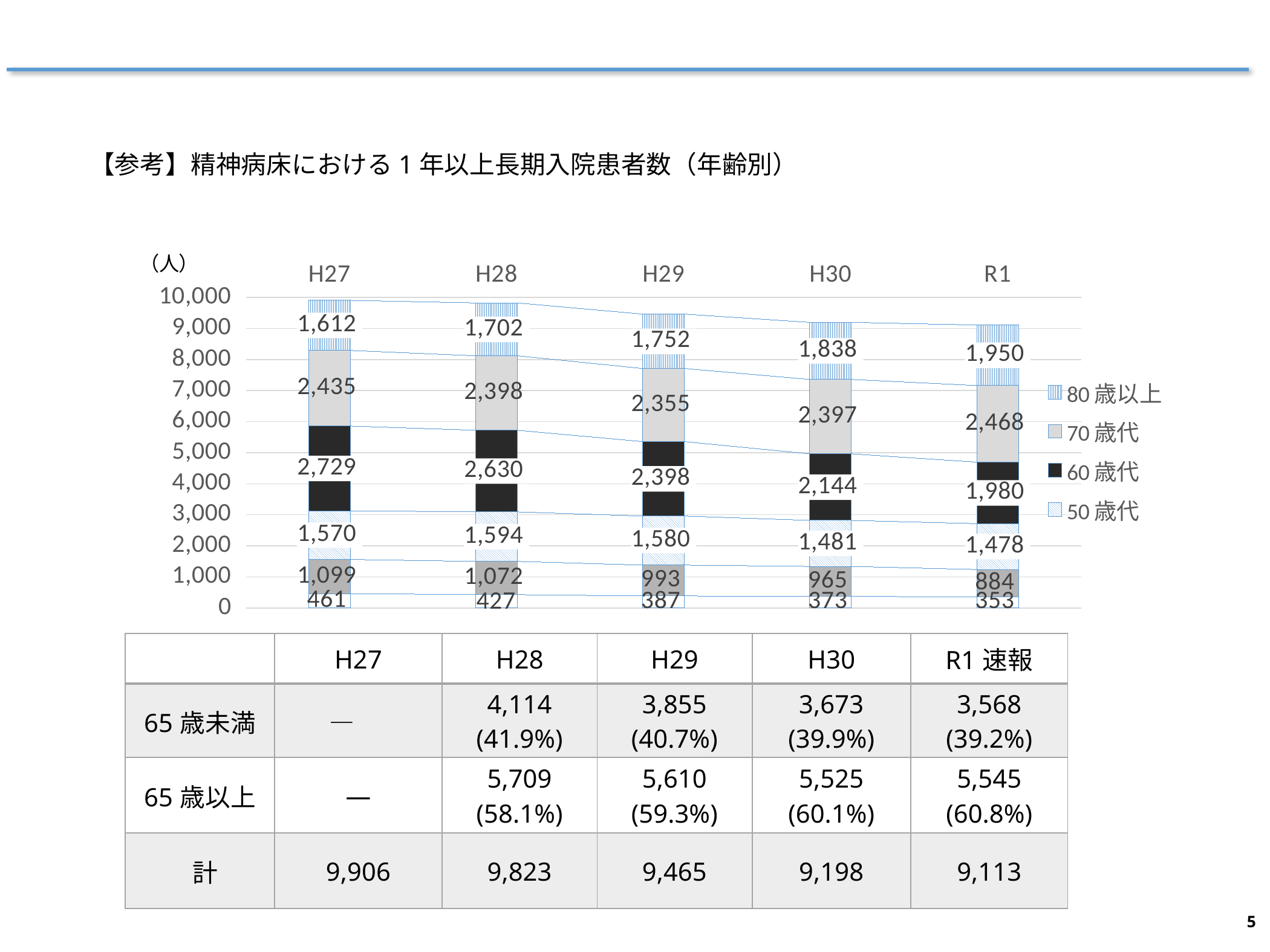
How many series does the chart's legend list? 4 How many year categories are plotted along the x axis of the chart? 5 What is the value of the 60歳代 segment for H27? 2,729 What is the value of the 70歳代 segment for H29? 2,355 What is the difference between the 60歳代 values for H27 and R1? 749 Does the 60歳代 segment rise or fall from H27 to R1? fall What is the value of the 80歳以上 segment for R1? 1,950 What kind of chart is shown on the slide? stacked bar chart In which year is the 60歳代 segment the smallest? R1 What is the value of the 50歳代 segment for H30? 1,481 In which year is the 80歳以上 segment the largest? R1 Which is larger, the 70歳代 value for H28 or the 70歳代 value for H30? H28